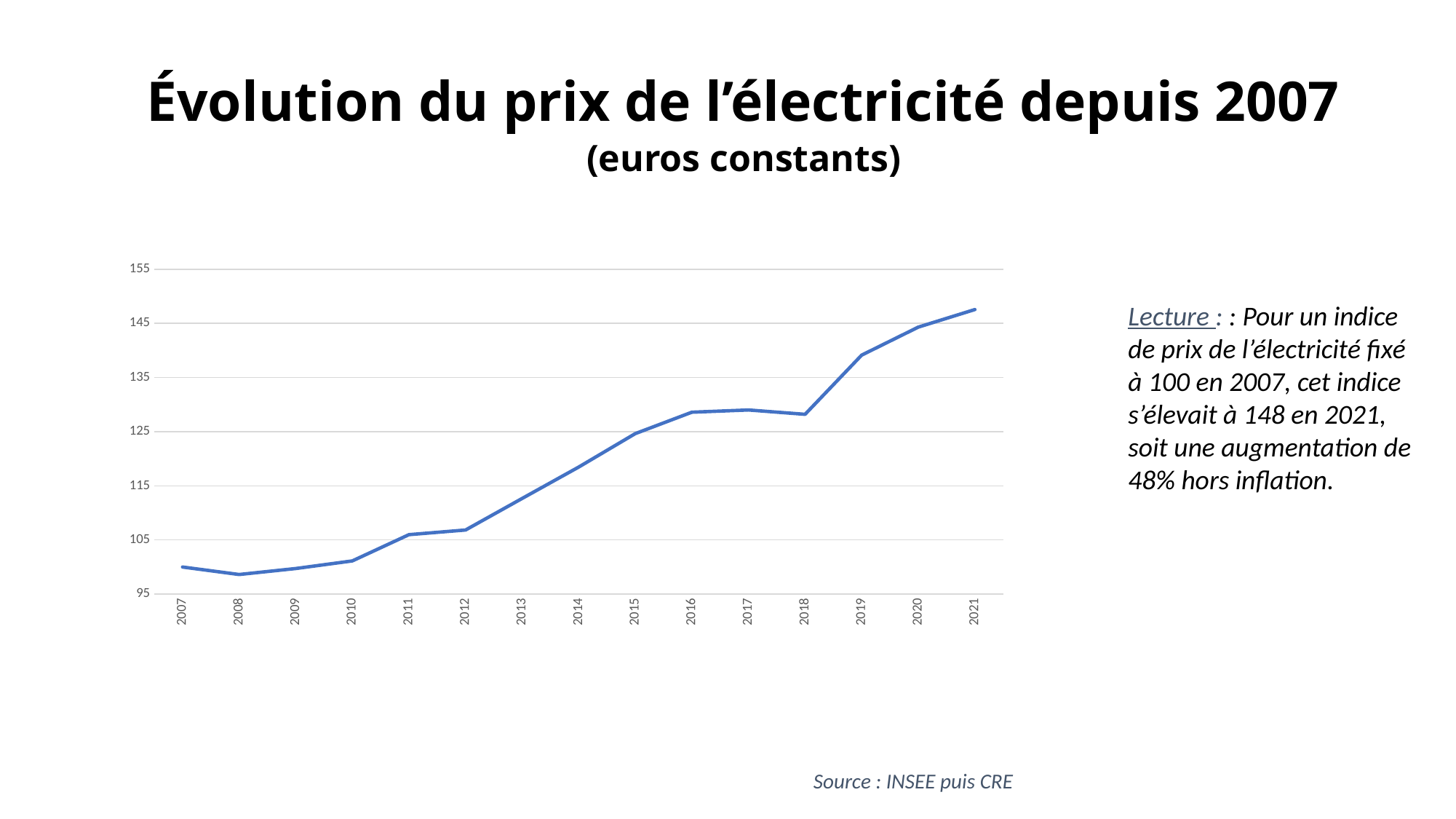
Is the value for 2010 greater or less than 105? less Which year has the larger value, 2016 or 2019? 2019 How many years are plotted on the x axis of the chart? 15 What source is cited for the chart? INSEE puis CRE Is the value for 2019 greater or less than 135? greater What kind of chart is shown on the slide? line chart According to the slide, what was the electricity price index in 2007? 100 According to the slide, what was the electricity price index in 2021? 148 Which year has the highest value on the chart? 2021 Which year has the lowest value on the chart? 2008 Do the values generally rise or fall from 2007 to 2021? rise Is the value for 2016 greater or less than 125? greater